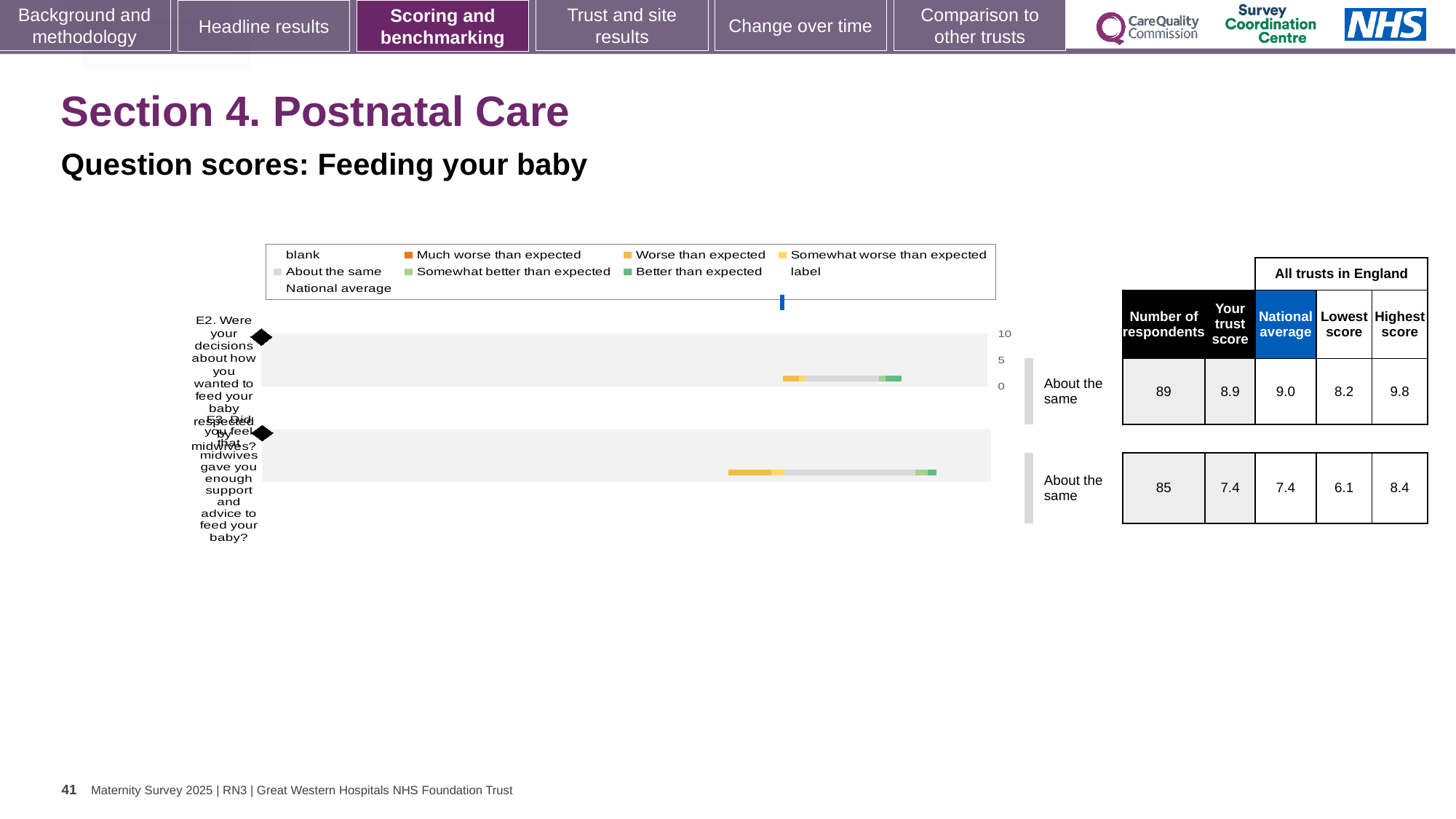
What is the trust score for E2 (decisions about how you wanted to feed your baby respected by midwives)? 8.9 What is the lowest score among all trusts in England for E3? 6.1 What benchmark category is shown next to the bar for E2? About the same Which question had more respondents, E2 or E3? E2 What kind of chart is used to show the question scores for Feeding your baby? Bar chart What is the highest score among all trusts in England for E3? 8.4 How many respondents answered question E2? 89 What is the national average for E3 (midwives gave you enough support and advice to feed your baby)? 7.4 What is the difference between the highest score and the lowest score for E2? 1.6 By how much does the national average for E2 exceed the trust score for E2? 0.1 What colour does the legend use for 'Better than expected'? Green How many questions (categories) are plotted in the Feeding your baby chart? 2